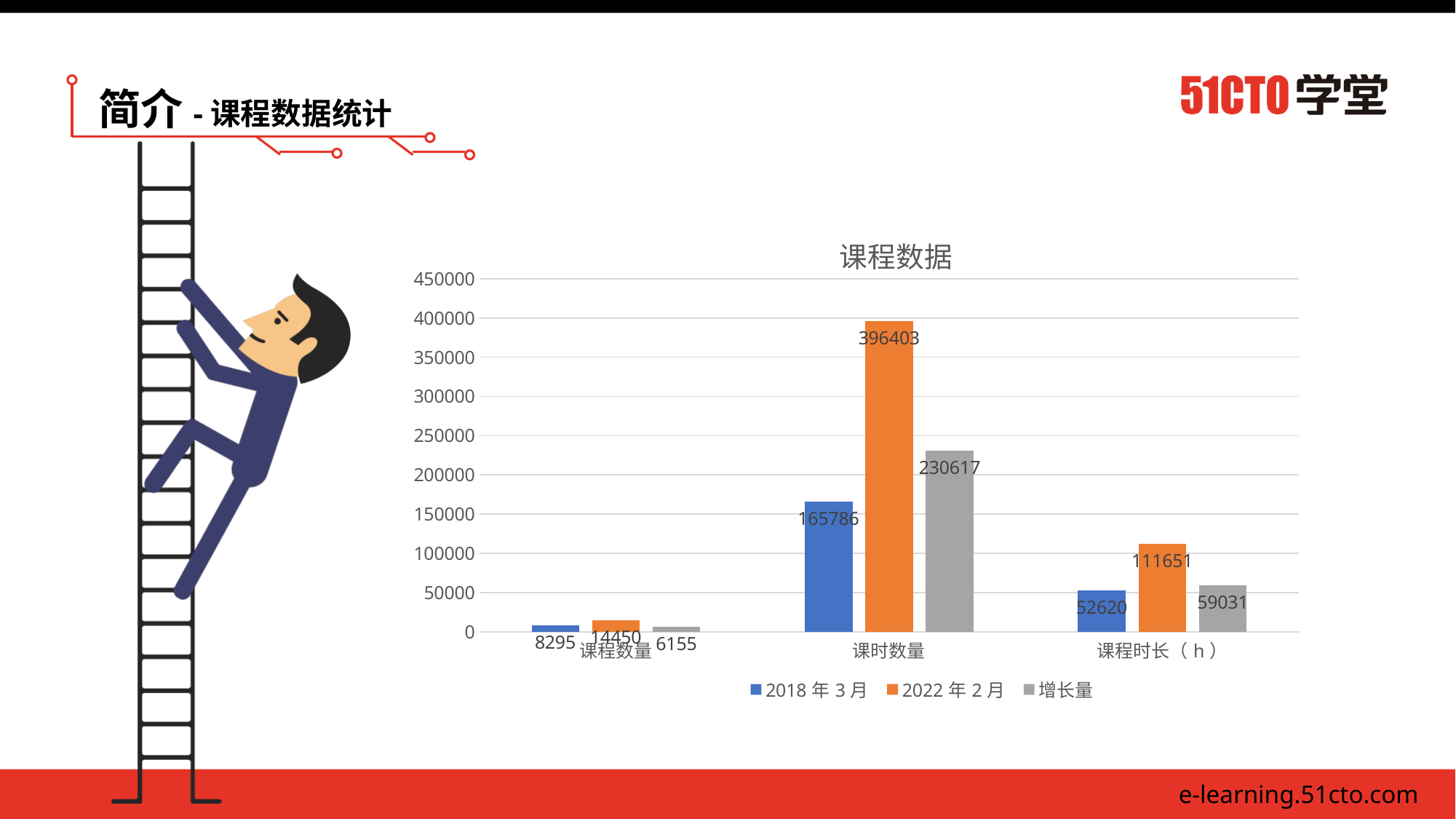
Which category has the lowest value for the 2018 年 3 月 series? 课程数量 How many categories are shown on the x axis? 3 Which category has the highest value for the 2022 年 2 月 series? 课时数量 Which is larger: the 增长量 for 课时数量 or the 2018 年 3 月 value for 课时数量? 增长量 for 课时数量 How many series does the legend list? 3 What is the difference between the 2022 年 2 月 and 2018 年 3 月 values for 课程时长（h）? 59031 What is the title of the chart? 课程数据 What is the 增长量 value for 课程时长（h）? 59031 What is the value for 2022 年 2 月 in the 课时数量 category? 396403 What is the value for 2018 年 3 月 in the 课程数量 category? 8295 What kind of chart is shown on the slide? bar chart Is the 2022 年 2 月 value for 课时数量 greater or less than 350000? greater